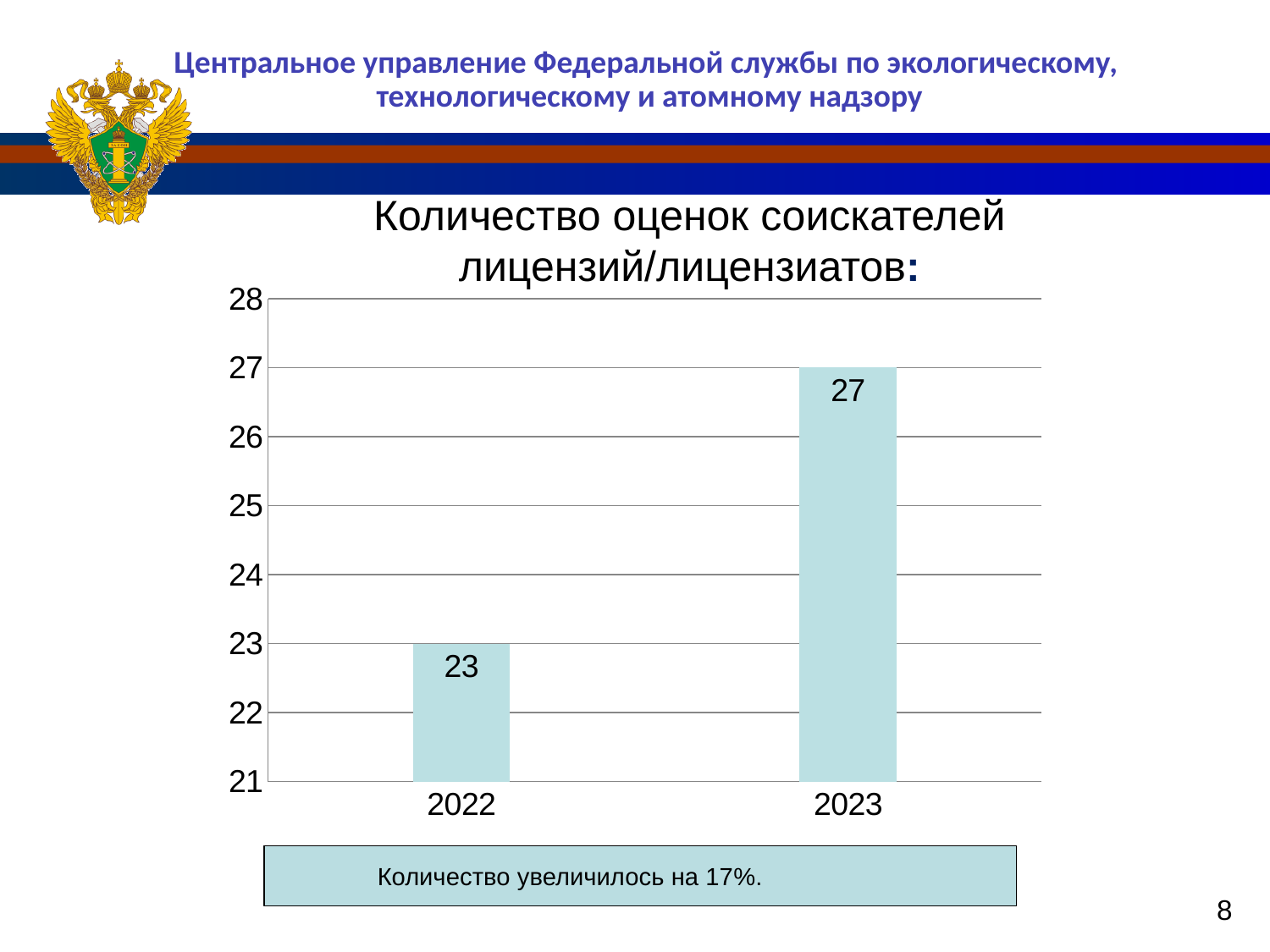
What is the value for 2023? 27 Is the value for 2023 greater or less than 25? greater How many categories are shown on the x axis? 2 What is the title of the chart? Количество оценок соискателей лицензий/лицензиатов: Is the value for 2022 greater or less than 24? less What is the difference between the values for 2023 and 2022? 4 What is the value for 2022? 23 Which year has the highest value? 2023 Which year has the lowest value? 2022 Do the values rise or fall from 2022 to 2023? rise Which is larger, the value for 2022 or the value for 2023? 2023 What kind of chart is shown on the slide? bar chart